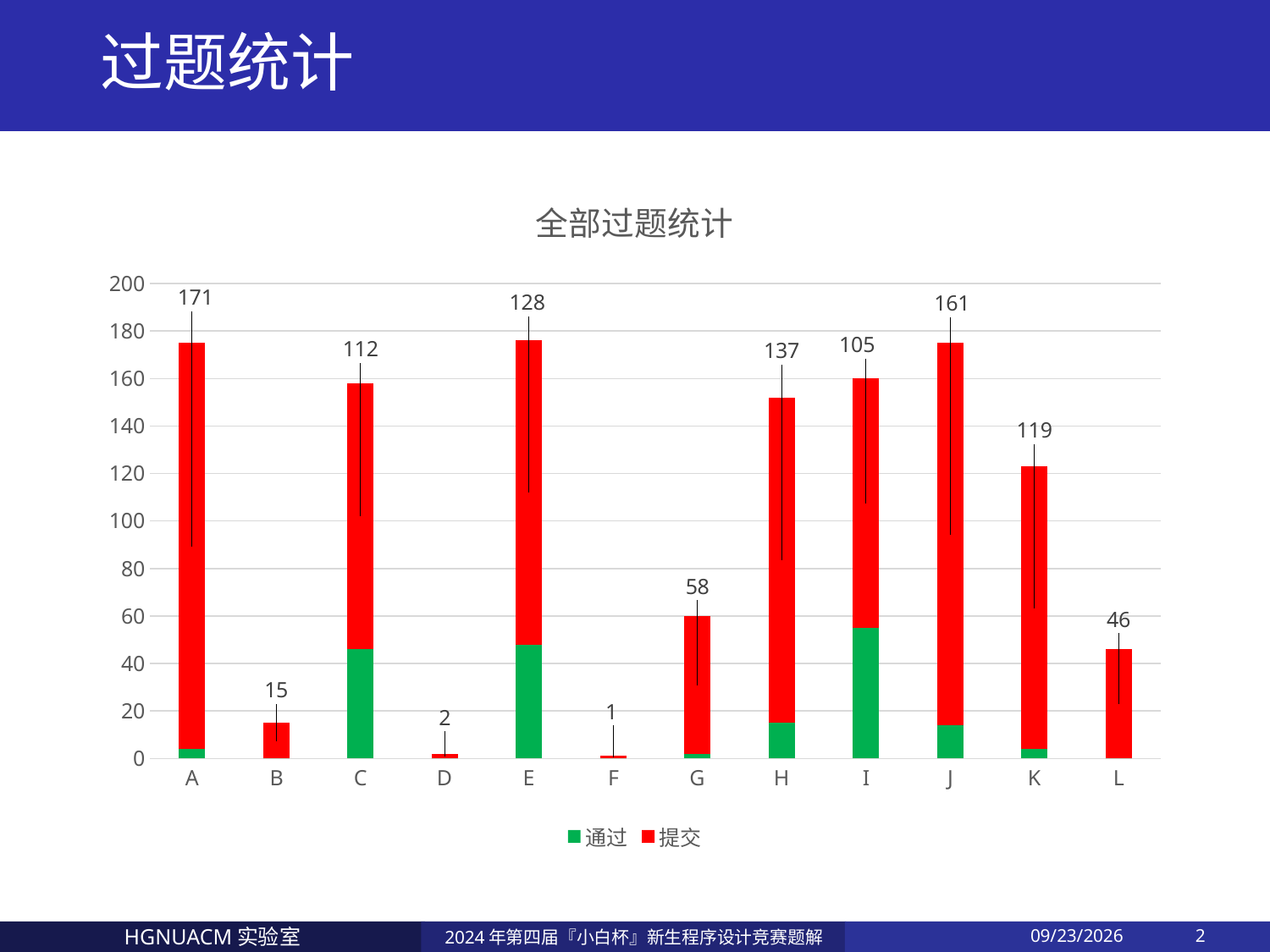
Is the total height of the stacked bar for I greater or less than 140? greater Which category has the lowest 提交 value? F What is the 提交 value for category G? 58 How many series does the legend list? 2 What is the difference between the 提交 values for A and J? 10 What is the 提交 value for category K? 119 How many categories are shown on the x axis? 12 What kind of chart is shown? Stacked bar chart Which category has the highest 提交 value? A Which has a larger 提交 value, H or I? H What is the 提交 value for category A? 171 What is the title of the chart? 全部过题统计